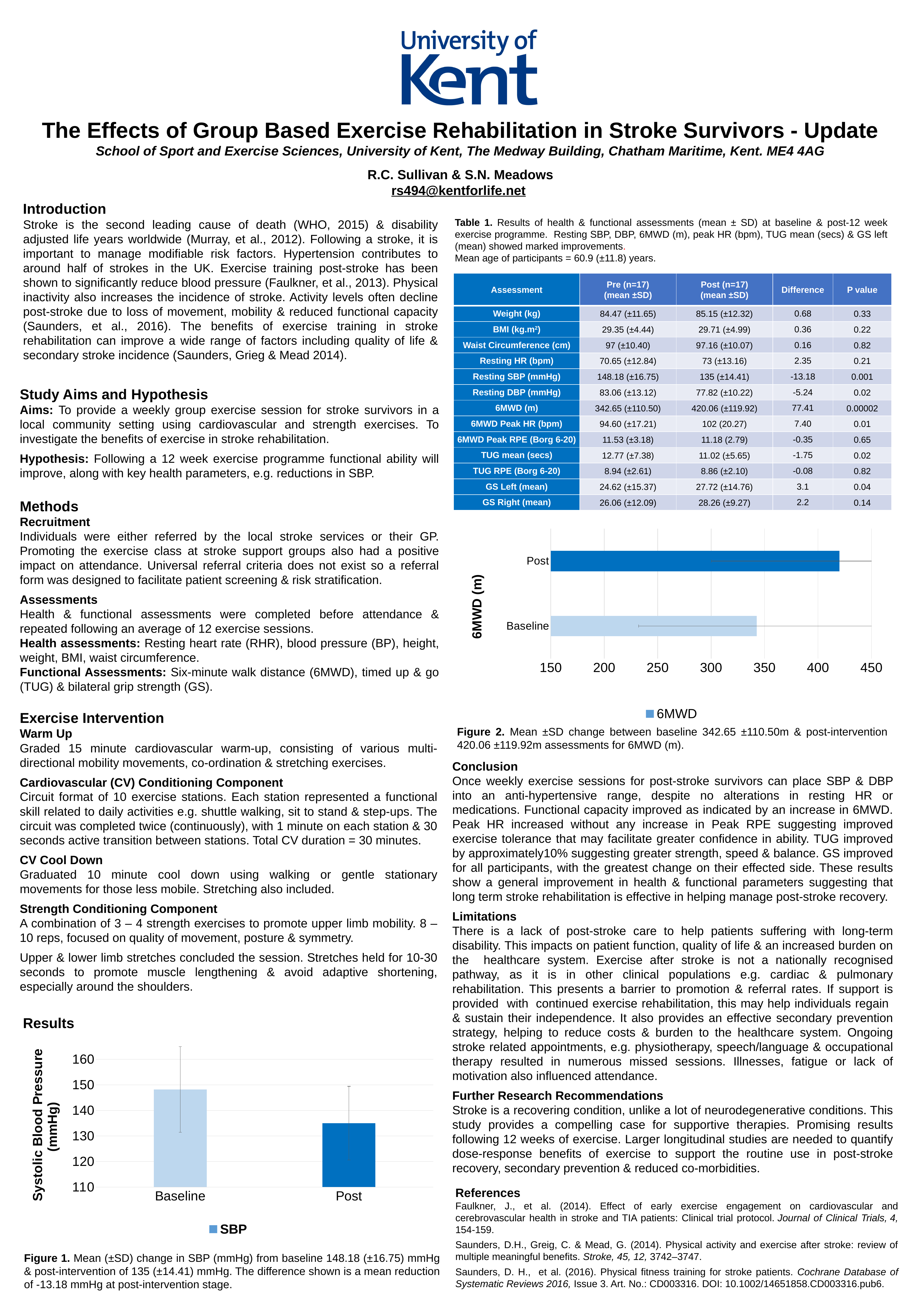
In the Systolic Blood Pressure chart (Figure 1), how many categories are plotted? 2 In the Systolic Blood Pressure chart (Figure 1), which category has the higher value, Baseline or Post? Baseline In the 6MWD chart (Figure 2), is the value for Baseline greater or less than 350? less In the 6MWD chart (Figure 2), how many series does the legend list? 1 In the Systolic Blood Pressure chart (Figure 1), what series name does the legend show? SBP In the 6MWD chart (Figure 2), what kind of chart is shown? bar chart In the 6MWD chart (Figure 2), which category has the higher value, Post or Baseline? Post In the 6MWD chart (Figure 2), what is the label on the vertical axis? 6MWD (m) In the 6MWD chart (Figure 2), is the value for Post greater or less than 400? greater In the Systolic Blood Pressure chart (Figure 1), what kind of chart is shown? bar chart In the Systolic Blood Pressure chart (Figure 1), is the value for Baseline greater or less than 140? greater